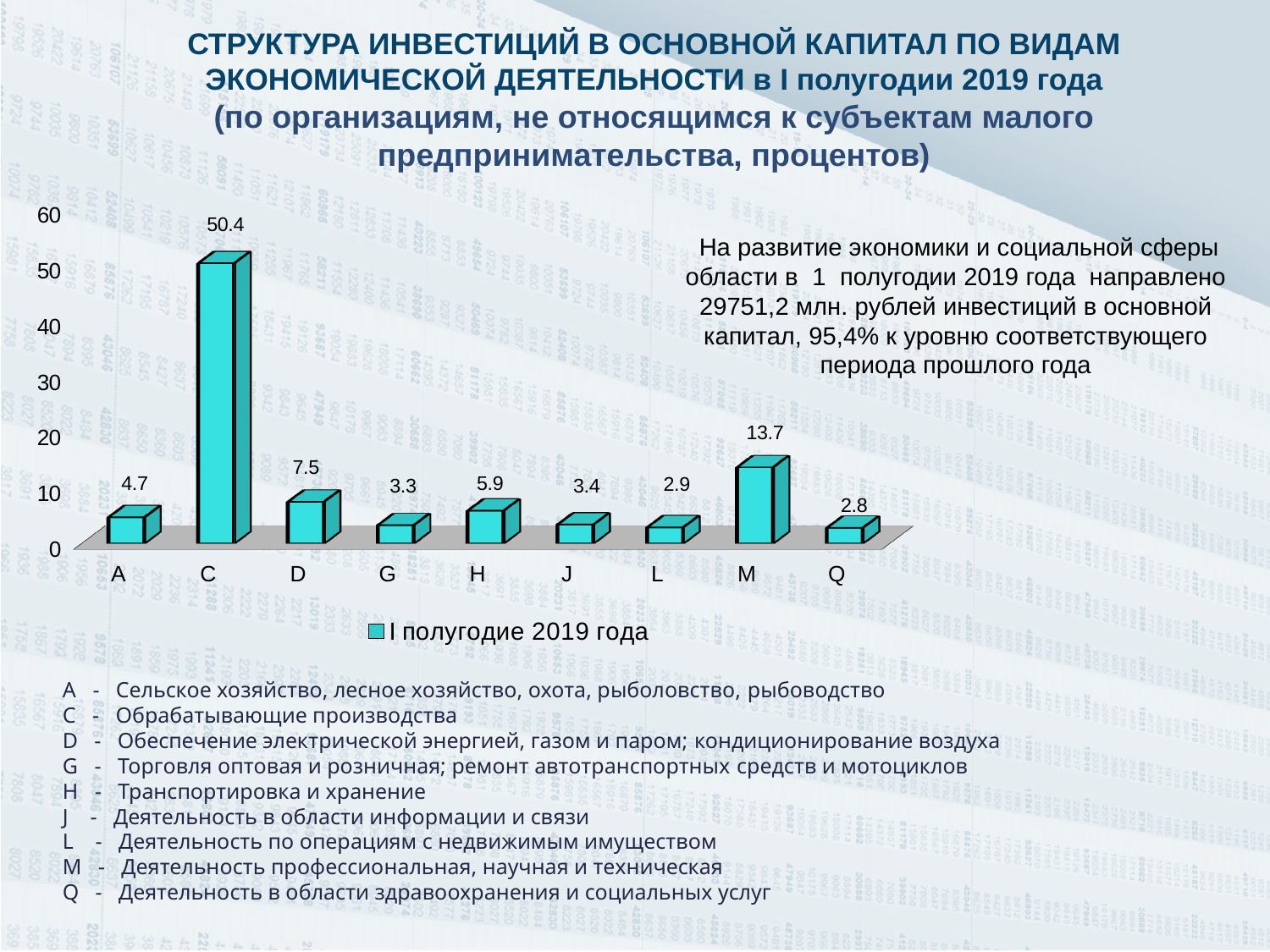
What is the value for category A? 4.7 Is the value for category C greater or less than 50? greater Which category has the lowest value? Q Which category has the highest value? C What kind of chart is shown on the slide? bar chart What is the difference between the values for C and M? 36.7 How many categories are shown on the x axis? 9 Which is larger, the value for D or the value for H? D What is the legend entry for the series? I полугодие 2019 года How many series does the legend list? 1 What is the value for category C? 50.4 What is the value for category M? 13.7